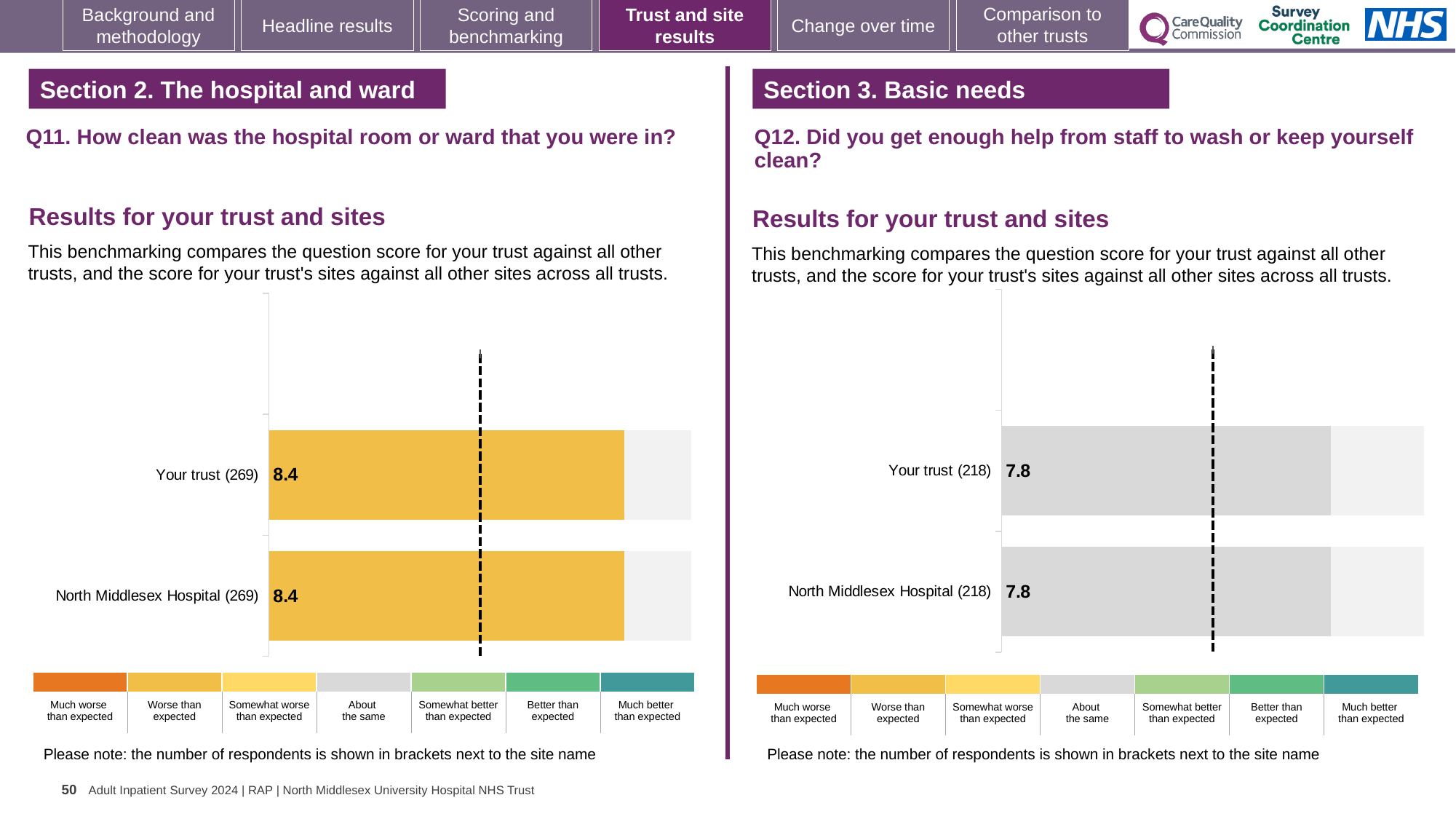
On the Q11 chart (left), what is the score for North Middlesex Hospital? 8.4 On the Q11 chart (left), how many respondents are shown in brackets next to Your trust? 269 On the Q12 chart (right), what is the score for North Middlesex Hospital? 7.8 On the Q11 chart (left), what is the score for Your trust? 8.4 How many bars are plotted on the Q12 chart (right)? 2 On the Q12 chart (right), how many respondents are shown in brackets next to North Middlesex Hospital? 218 On the Q12 chart (right), what is the score for Your trust? 7.8 On the Q11 chart (left), what is the difference between the Your trust score and the North Middlesex Hospital score? 0 How many bars are plotted on the Q11 chart (left)? 2 Is the Your trust score on the Q11 chart (left) larger or smaller than the Your trust score on the Q12 chart (right)? Larger On the Q12 chart (right), what is the difference between the Your trust score and the North Middlesex Hospital score? 0 What kind of chart is used for the Q11 results on the left? Bar chart